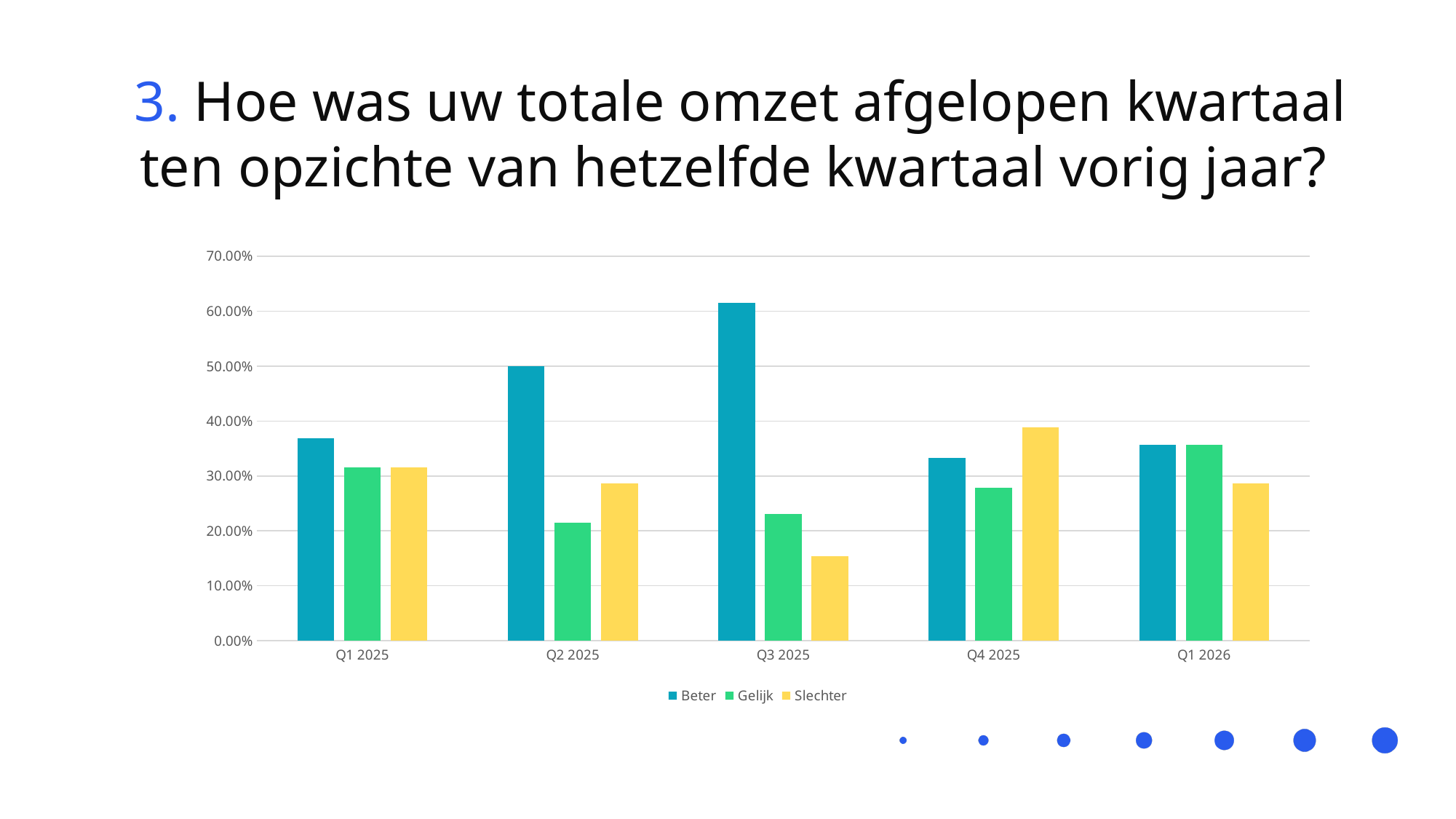
In which quarter is the Beter value highest? Q3 2025 In which quarter is the Slechter value lowest? Q3 2025 In Q2 2025, which is larger: Gelijk or Slechter? Slechter Is the value for Beter in Q3 2025 greater or less than 60.00%? greater How many quarters are shown on the x axis? 5 What kind of chart is shown on the slide? Bar chart In which quarter is the Slechter value highest? Q4 2025 What is the value for Beter in Q2 2025? 50.00% How many series does the legend list? 3 What are the three series named in the legend? Beter, Gelijk, Slechter Is the value for Slechter in Q3 2025 greater or less than 20.00%? less In Q4 2025, which is larger: Beter or Slechter? Slechter